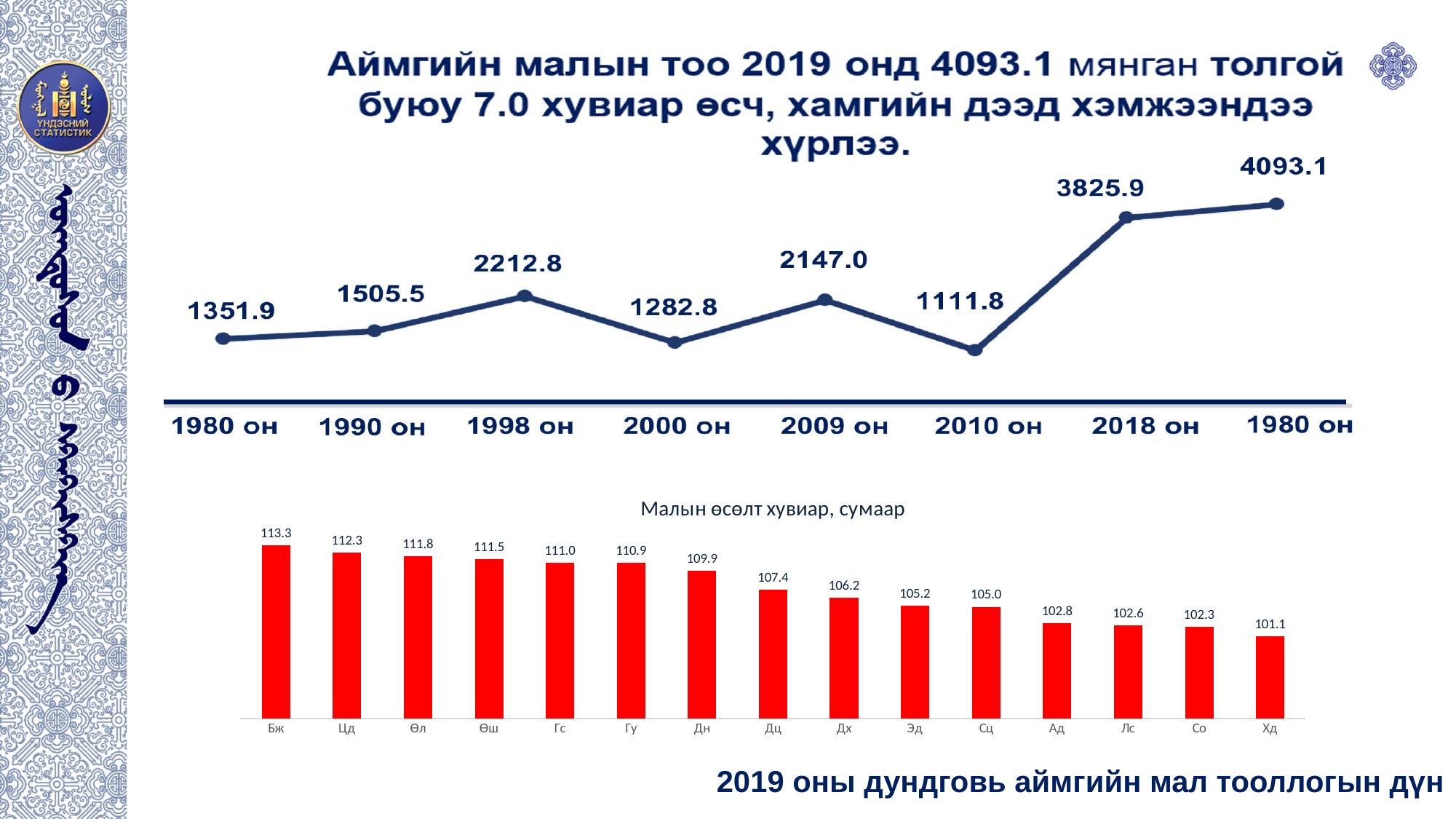
In the top line chart, what is the value for 2018 он? 3825.9 In the bar chart 'Малын өсөлт хувиар, сумаар', which category has the lowest value? Хд In the bar chart 'Малын өсөлт хувиар, сумаар', how many categories are shown? 15 In the bar chart 'Малын өсөлт хувиар, сумаар', what is the value for Дц? 107.4 In the bar chart 'Малын өсөлт хувиар, сумаар', what is the difference between the values for Бж and Хд? 12.2 In the bar chart 'Малын өсөлт хувиар, сумаар', which category has the highest value? Бж In the top line chart, which year has the lowest value? 2010 он In the top line chart, which is larger, the value for 1998 он or the value for 2009 он? 1998 он In the top line chart, what is the value for 1998 он? 2212.8 In the top line chart, what is the difference between the values for 2018 он and 2009 он? 1678.9 In the top line chart, what is the value for 2010 он? 1111.8 What kind of chart is the top chart on the slide? Line chart